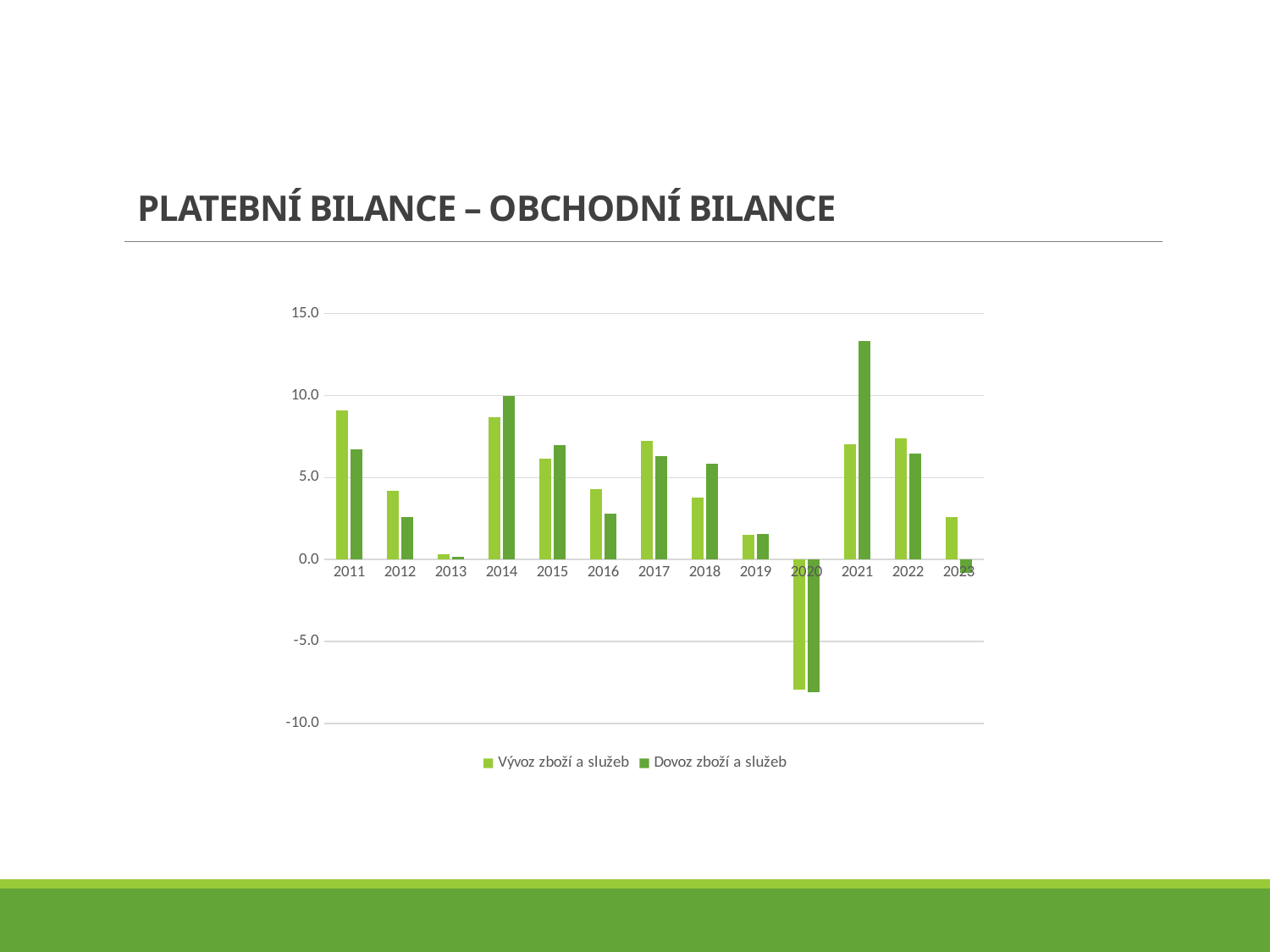
Is the value for Vývoz zboží a služeb in 2020 greater or less than -5.0? less Is the value for Vývoz zboží a služeb in 2011 greater or less than 5.0? greater In 2021, which is larger: Vývoz zboží a služeb or Dovoz zboží a služeb? Dovoz zboží a služeb In which year is the value for Dovoz zboží a služeb the lowest? 2020 Which series is shown in the darker green colour in the legend? Dovoz zboží a služeb What is the title of the slide containing the chart? PLATEBNÍ BILANCE – OBCHODNÍ BILANCE In which year is the value for Vývoz zboží a služeb the lowest? 2020 What kind of chart is shown on the slide? bar chart How many years are shown on the x axis of the chart? 13 How many series does the legend list? 2 Is the value for Dovoz zboží a služeb in 2021 greater or less than 10.0? greater In which year is the value for Dovoz zboží a služeb the highest? 2021